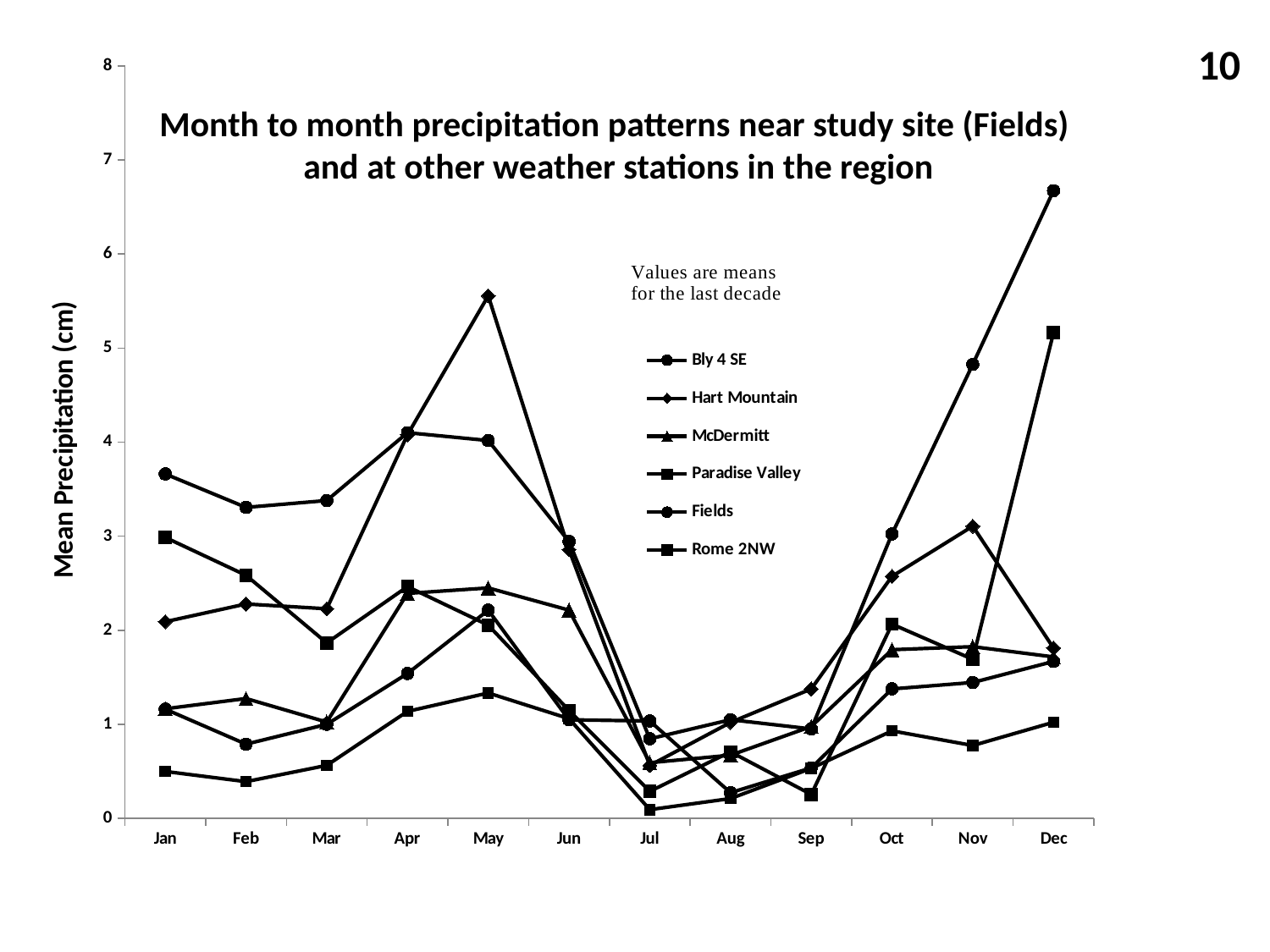
Is the value for McDermitt in January greater or less than 2? less In May, which is larger: the value for Hart Mountain or the value for McDermitt? Hart Mountain How many months are shown along the x axis? 12 How many series does the legend list? 6 What is the label of the y axis? Mean Precipitation (cm) In which month does Hart Mountain reach its highest value? May Does the value for Hart Mountain rise or fall from March to May? rise What kind of chart is shown on the slide? line chart Is the value for McDermitt in April greater or less than 2? greater Is the value for Hart Mountain in November greater or less than 2? greater What is the title of the chart? Month to month precipitation patterns near study site (Fields) and at other weather stations in the region